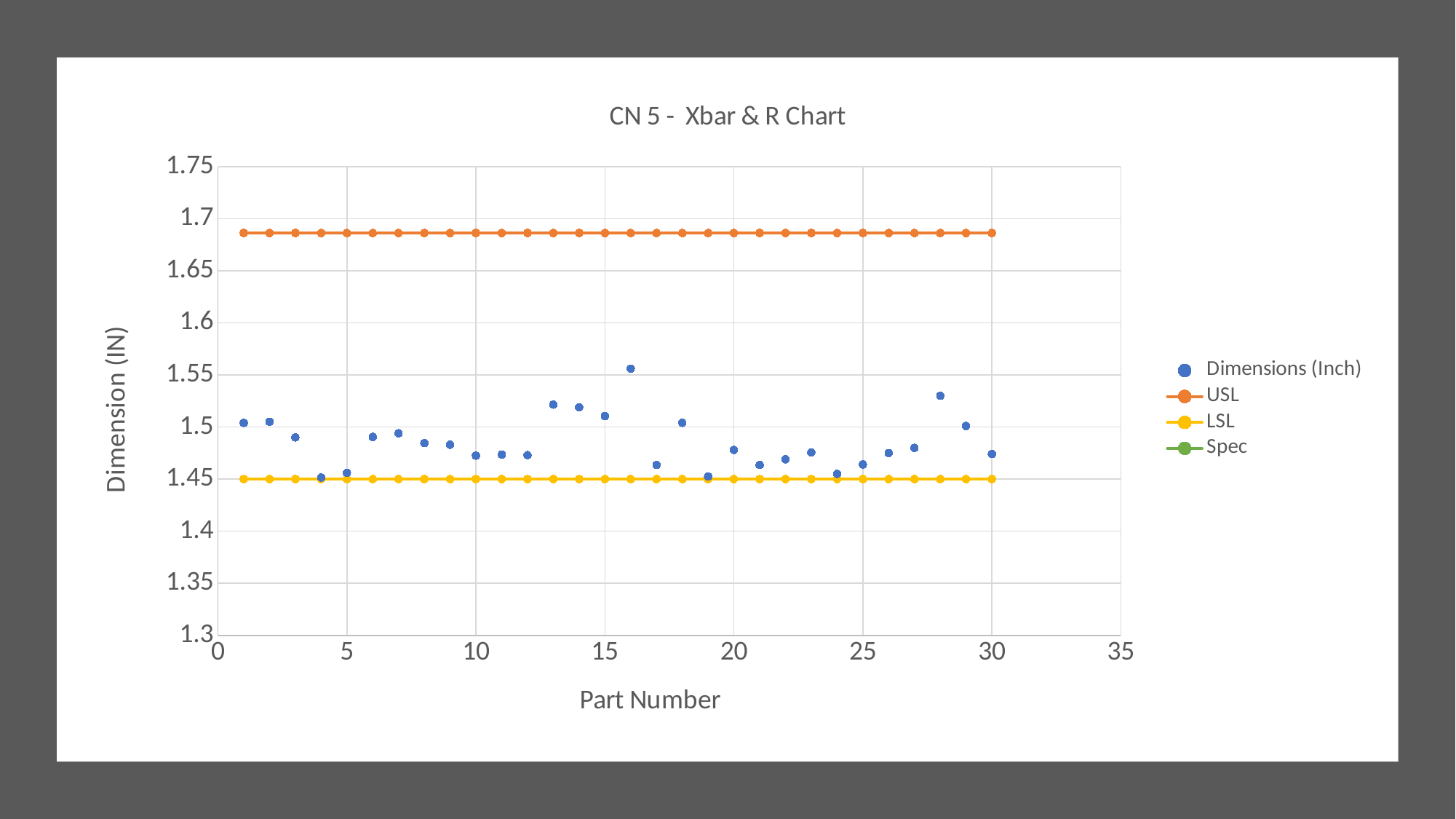
What is the title of the chart? CN 5 - Xbar & R Chart Is the Dimensions (Inch) value for part number 10 greater or less than 1.5? less How many data points are plotted for the Dimensions (Inch) series? 30 Is the Dimensions (Inch) value for part number 28 greater or less than 1.5? greater Which is larger, the Dimensions (Inch) value for part number 16 or for part number 20? part number 16 At which part number is the Dimensions (Inch) value highest? 16 Is the USL value greater or less than 1.7? less What kind of chart is shown on the slide? scatter chart How many series does the legend list? 4 What is the value of the LSL line? 1.45 What is the label of the vertical axis? Dimension (IN)